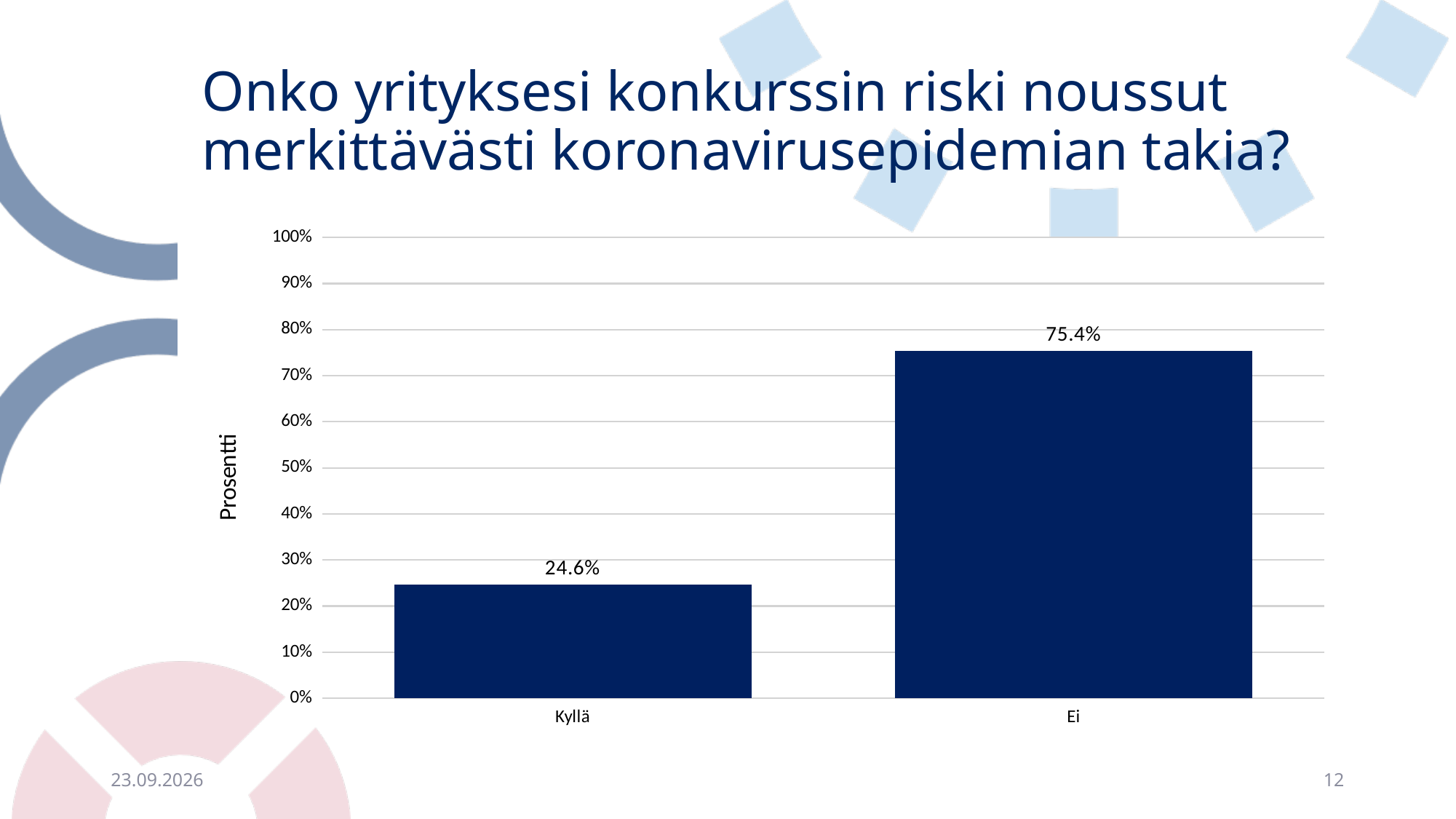
Which category has the highest value? Ei Which is larger, the value for Kyllä or the value for Ei? Ei How many categories are shown on the x axis? 2 What is the label of the vertical axis? Prosentti Which category has the lowest value? Kyllä What is the highest tick value shown on the vertical axis? 100% Is the value for Kyllä greater or less than 30%? less What kind of chart is shown on the slide? bar chart What is the value for Ei? 75.4% What is the value for Kyllä? 24.6% Is the value for Ei greater or less than 70%? greater What is the difference between the values for Ei and Kyllä? 50.8%